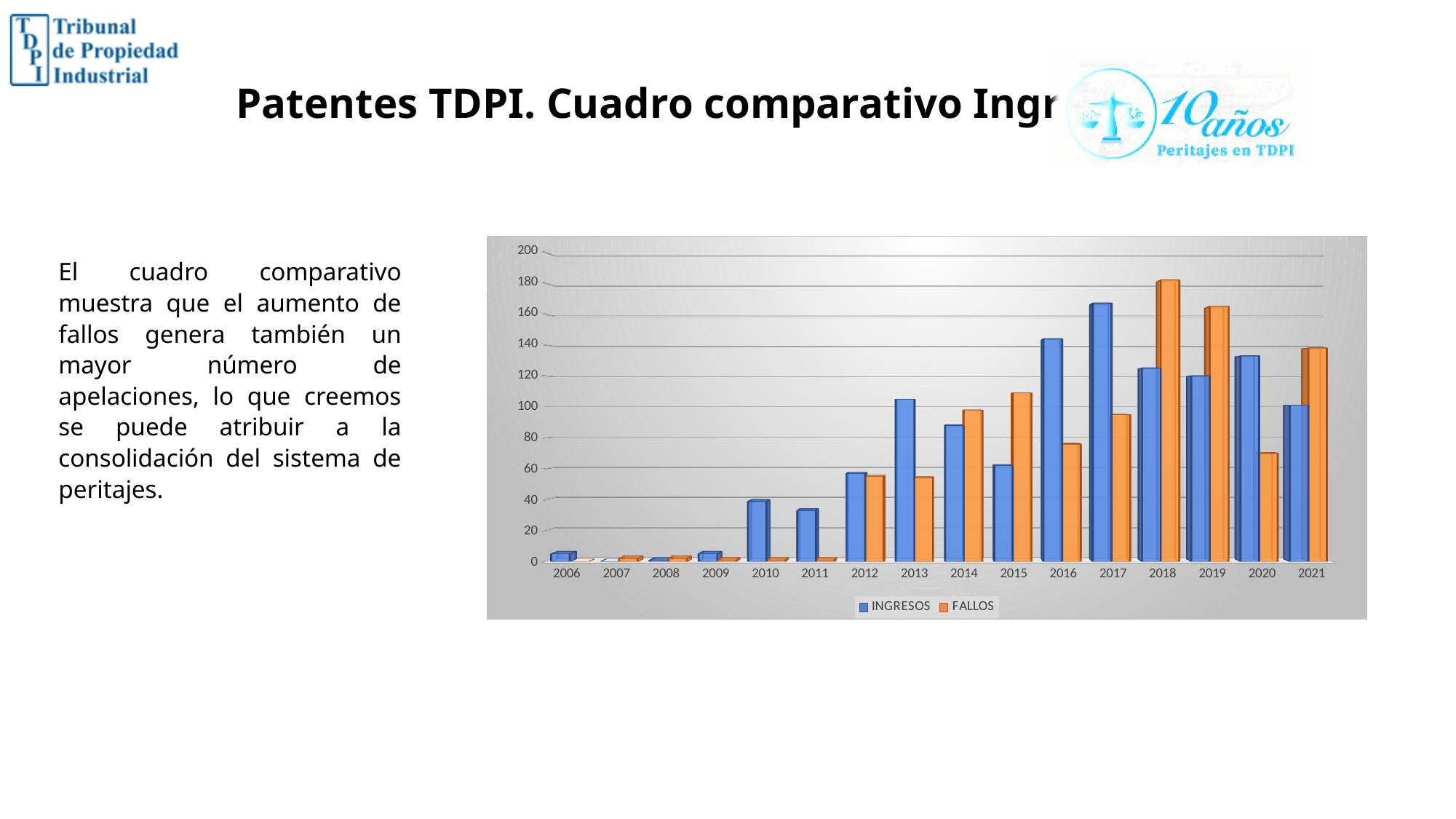
Is the INGRESOS value for 2017 greater or less than 160? greater How many series does the chart's legend list? 2 In which year is the INGRESOS value highest? 2017 How many years are shown on the x axis of the chart? 16 In 2018, which is larger, INGRESOS or FALLOS? FALLOS Is the INGRESOS value for 2011 greater or less than 40? less Is the FALLOS value for 2019 greater or less than 160? greater In 2016, which is larger, INGRESOS or FALLOS? INGRESOS What kind of chart is shown on the slide? bar chart Which colour represents the FALLOS series in the chart? orange In which year is the FALLOS value highest? 2018